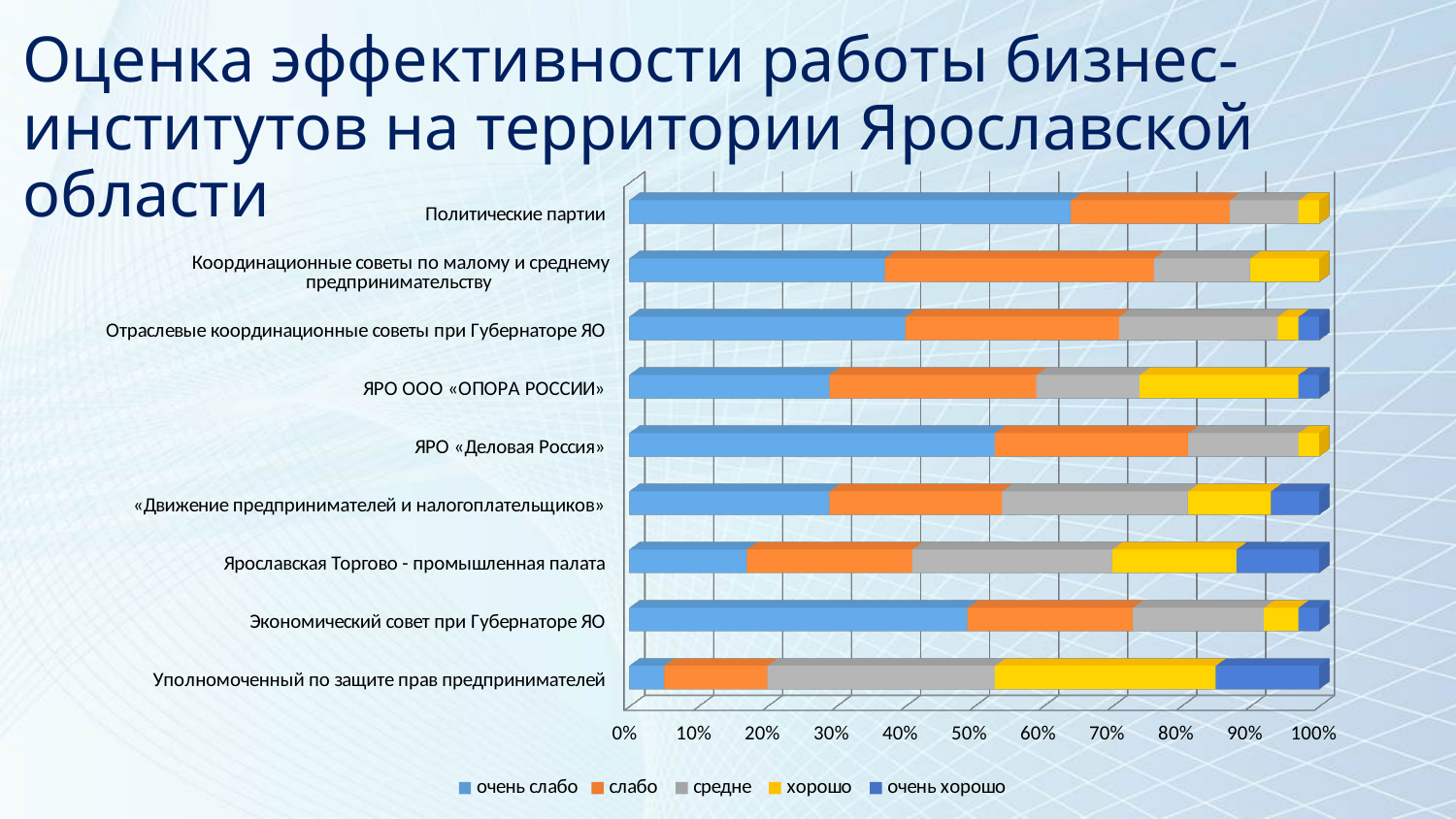
What is the last entry listed in the chart legend? очень хорошо Which has a larger "очень слабо" share: ЯРО «Деловая Россия» or Ярославская Торгово - промышленная палата? ЯРО «Деловая Россия» Which colour represents the "слабо" series in the chart? Orange Is the "очень слабо" share for Ярославская Торгово - промышленная палата greater or less than 20%? less Which category has the smallest share of "очень слабо" responses? Уполномоченный по защите прав предпринимателей Which category has the largest share of "хорошо" responses? Уполномоченный по защите прав предпринимателей How many categories (institutions) are plotted on the chart? 9 Is the "очень слабо" share for Политические партии greater or less than 50%? greater What kind of chart is shown on the slide? Stacked bar chart Which category has the largest share of "очень слабо" responses? Политические партии Is the "очень слабо" share for Уполномоченный по защите прав предпринимателей greater or less than 10%? less How many series does the legend list? 5